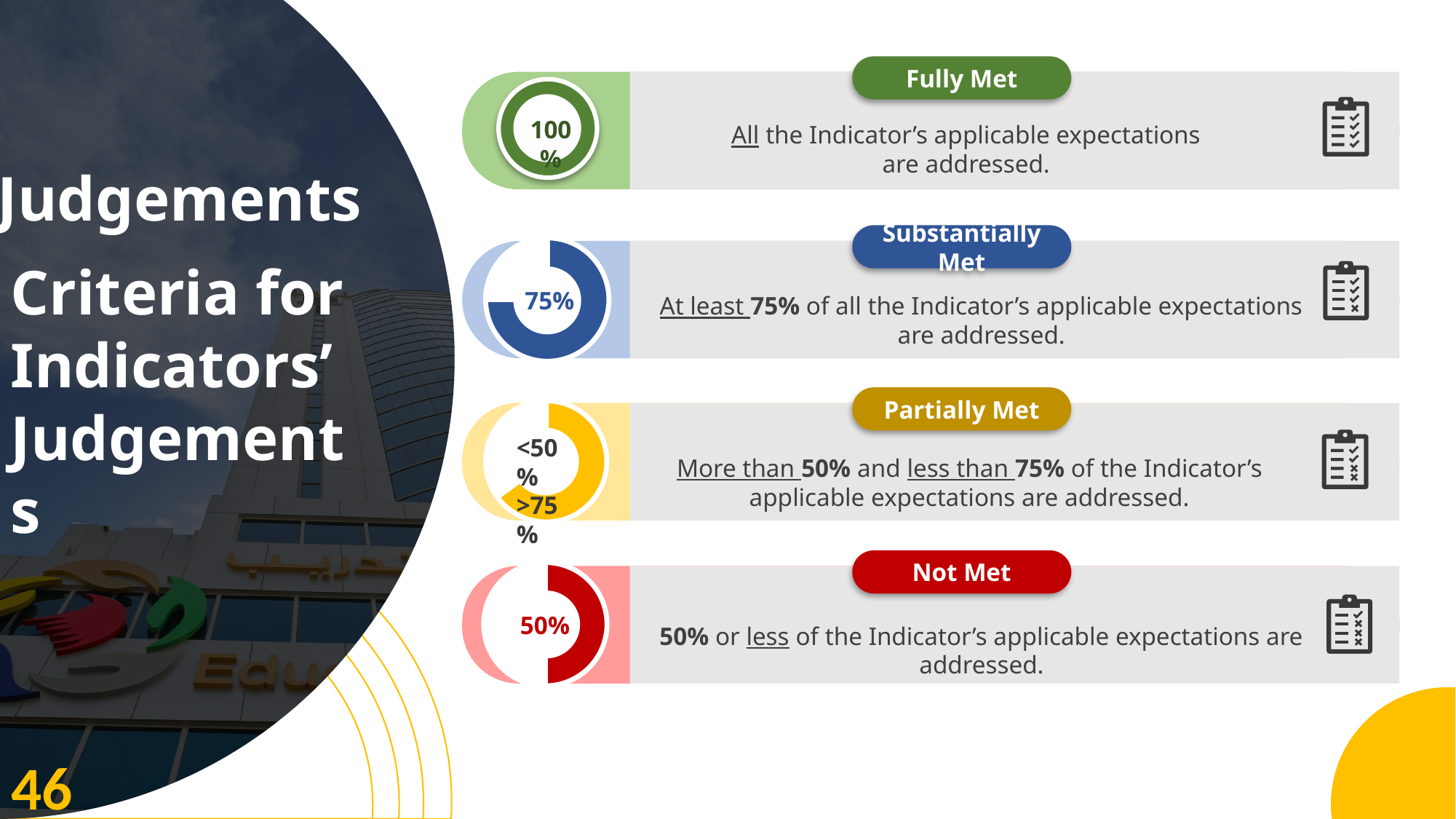
Which doughnut chart shows the lower value, the one next to "Substantially Met" or the one next to "Not Met"? Not Met What text is printed in the centre of the doughnut chart next to "Partially Met"? <50% >75% What kind of chart is used beside each judgement category on the slide? Doughnut chart What value is printed in the centre of the doughnut chart next to "Substantially Met"? 75% How many doughnut charts are shown on the slide? 4 Which doughnut chart shows the higher value, the one next to "Fully Met" or the one next to "Not Met"? Fully Met What value is printed in the centre of the doughnut chart next to "Fully Met"? 100% What is the difference between the value shown in the "Substantially Met" doughnut chart and the value shown in the "Not Met" doughnut chart? 25% What is the difference between the value shown in the "Fully Met" doughnut chart and the value shown in the "Not Met" doughnut chart? 50% What colour is the doughnut chart next to "Not Met"? Red What value is printed in the centre of the doughnut chart next to "Not Met"? 50% What colour is the doughnut chart next to "Substantially Met"? Blue